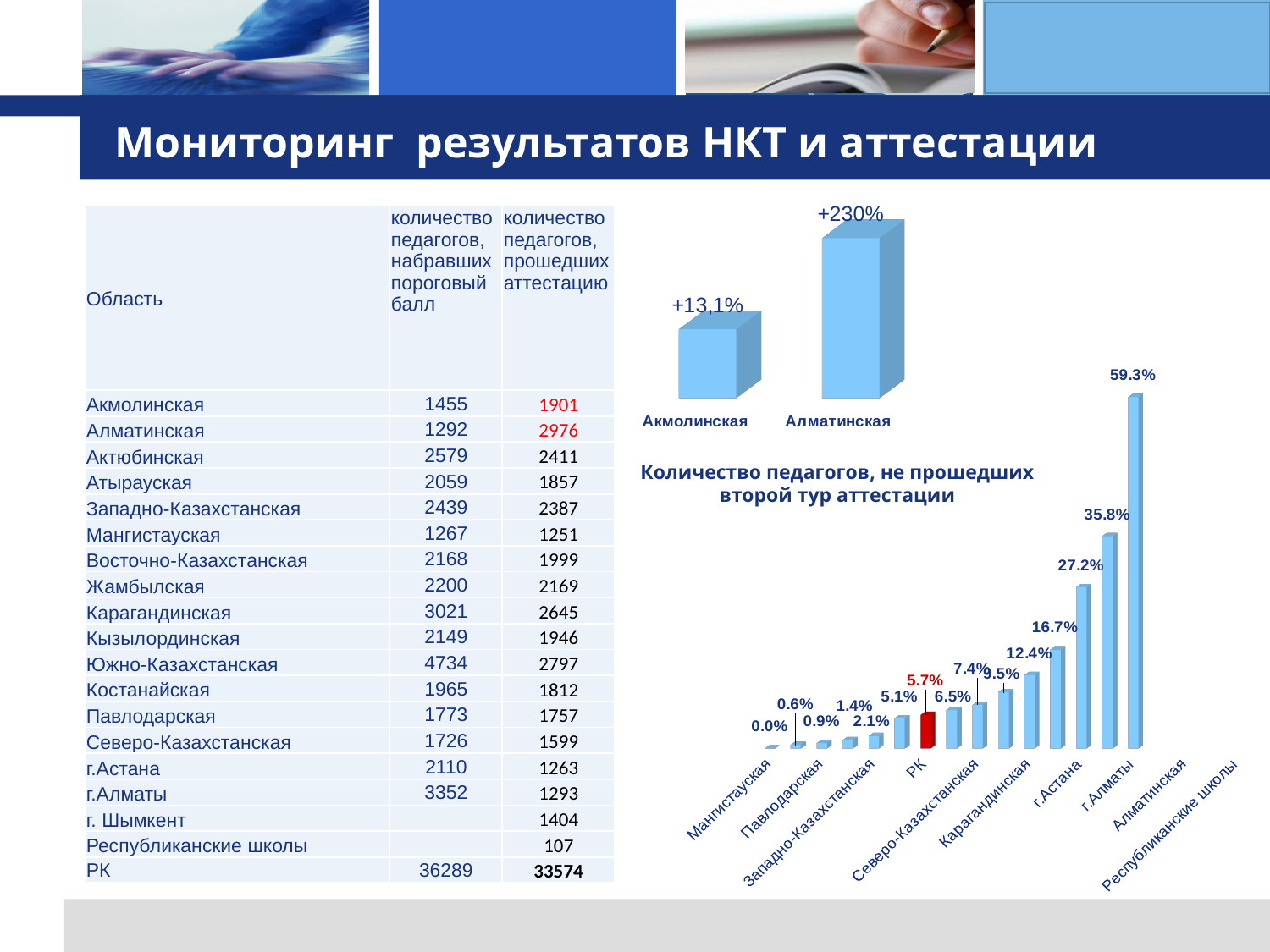
In the chart 'Количество педагогов, не прошедших второй тур аттестации', what is the value for РК? 5.7% In the chart 'Количество педагогов, не прошедших второй тур аттестации', do the values rise or fall from left to right? Rise In the top-right chart, which region has the higher value, Акмолинская or Алматинская? Алматинская What is the title of the larger chart at the bottom right? Количество педагогов, не прошедших второй тур аттестации In the chart 'Количество педагогов, не прошедших второй тур аттестации', what colour is the bar for РК? Red In the chart 'Количество педагогов, не прошедших второй тур аттестации', what is the highest value shown? 59.3% In the chart 'Количество педагогов, не прошедших второй тур аттестации', which category has the lowest value? Мангистауская What kind of chart is the top-right chart? Bar chart In the chart 'Количество педагогов, не прошедших второй тур аттестации', which category has the highest value? г.Алматы How many bars are in the top-right chart? 2 In the top-right chart, what is the value shown for Алматинская? +230% In the top-right chart, what is the value shown for Акмолинская? +13,1%